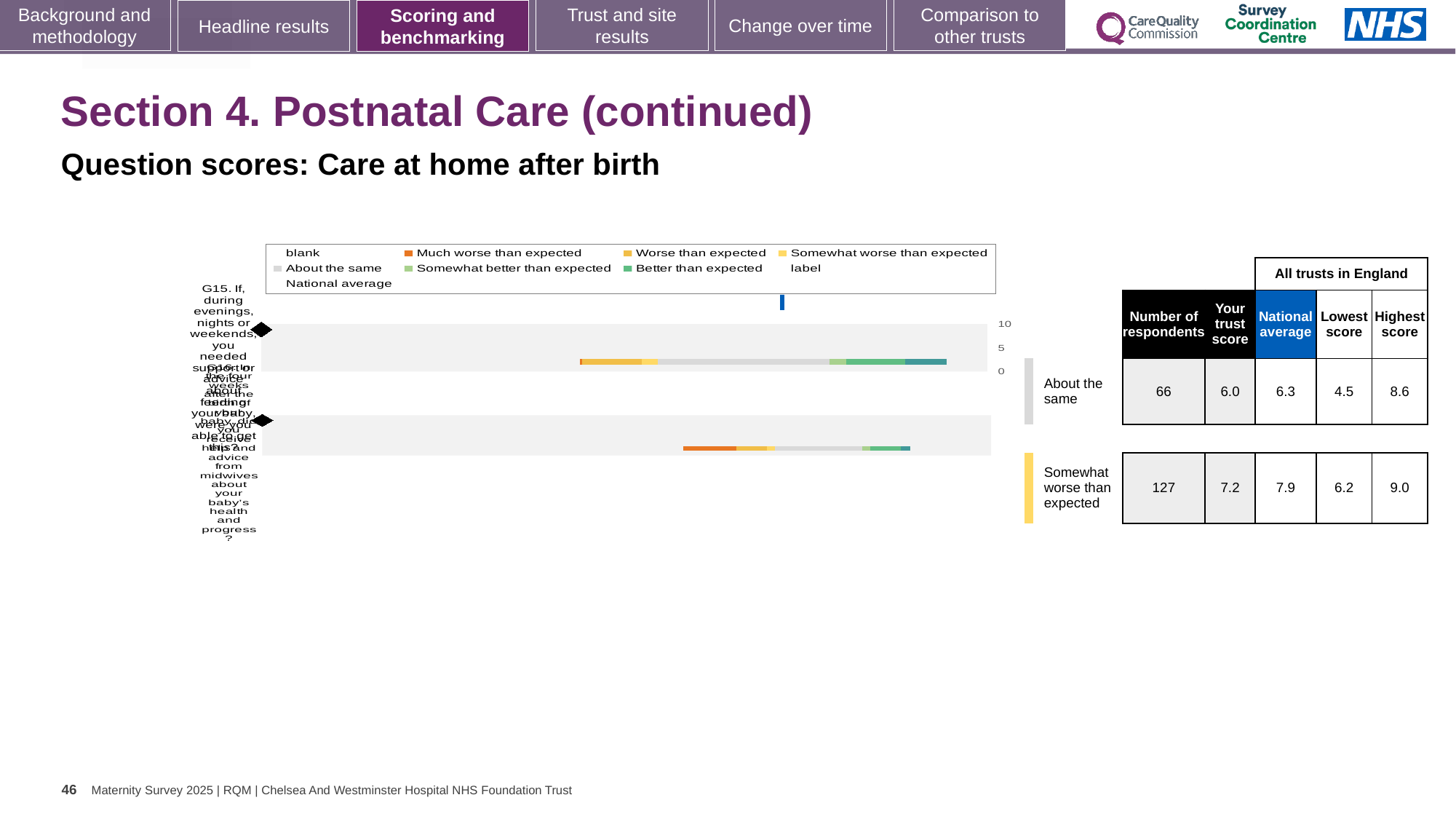
For the row labelled 'About the same', what is the difference between the highest score and the lowest score? 4.1 What is the 'Your trust score' for the row labelled 'Somewhat worse than expected'? 7.2 What colour is used in the legend for 'Much worse than expected'? orange In the table, how many respondents are listed for the row labelled 'Somewhat worse than expected'? 127 What is the 'Your trust score' for the row labelled 'About the same'? 6.0 In the table, how many respondents are listed for the row labelled 'About the same'? 66 What is the national average for the row labelled 'Somewhat worse than expected'? 7.9 What is the highest score among all trusts in England for the row labelled 'About the same'? 8.6 What is the lowest score among all trusts in England for the row labelled 'Somewhat worse than expected'? 6.2 For the row labelled 'Somewhat worse than expected', which is larger: the trust score or the national average? national average What kind of chart is shown on the slide? bar chart For the row labelled 'Somewhat worse than expected', what is the difference between the national average and the trust score? 0.7